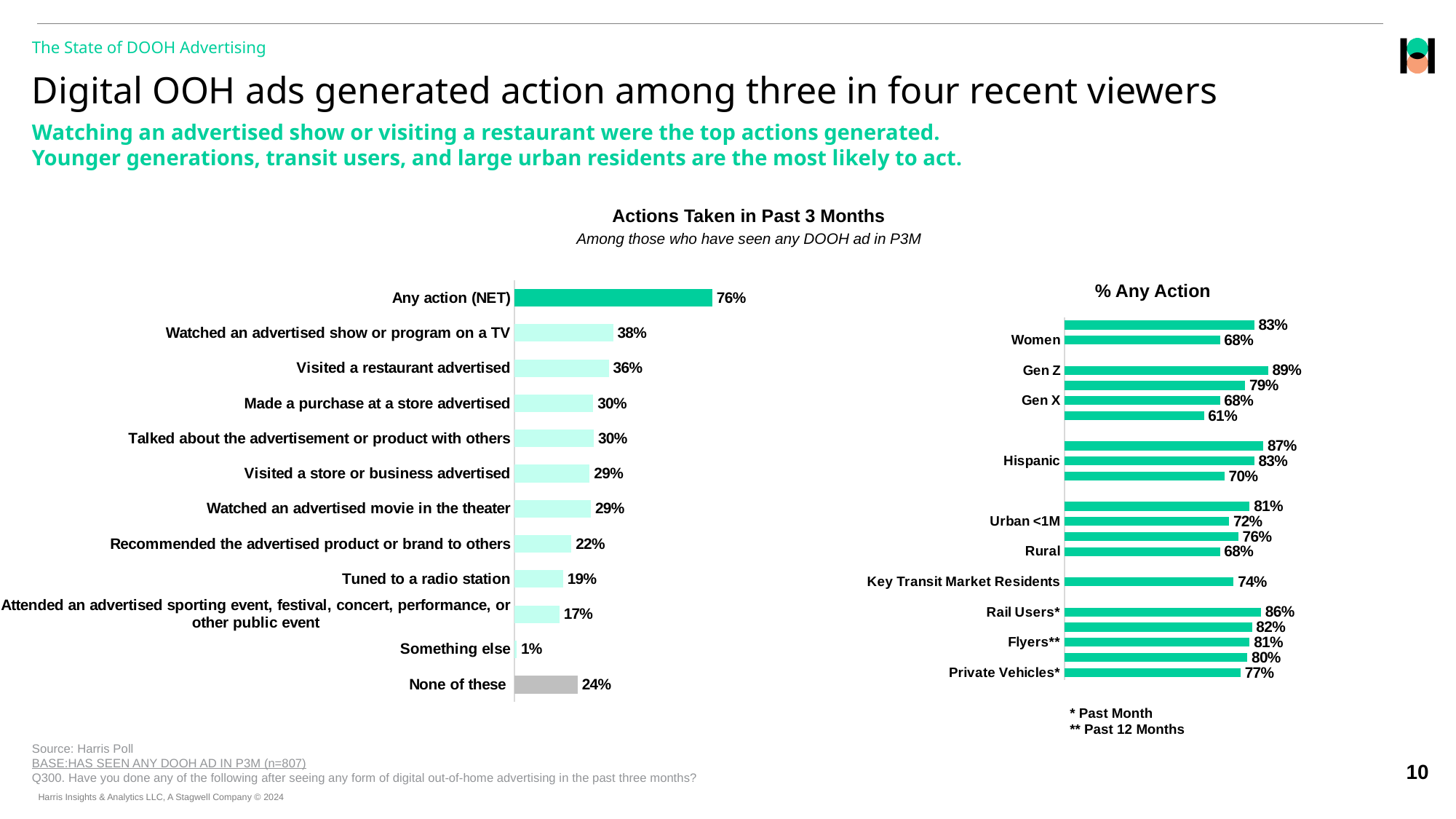
In the '% Any Action' chart, what is the value for 'Gen Z'? 89% In the '% Any Action' chart, what is the difference between 'Rail Users*' and 'Private Vehicles*'? 9% In the 'Actions Taken in Past 3 Months' chart, what is the value for 'Visited a restaurant advertised'? 36% In the 'Actions Taken in Past 3 Months' chart, which is larger: 'Recommended the advertised product or brand to others' or 'None of these'? None of these In the 'Actions Taken in Past 3 Months' chart, what is the difference between 'Watched an advertised show or program on a TV' and 'Visited a restaurant advertised'? 2% What type of chart is the 'Actions Taken in Past 3 Months' chart? Bar chart In the 'Actions Taken in Past 3 Months' chart, which category has the lowest value? Something else In the 'Actions Taken in Past 3 Months' chart, what is the value for 'Tuned to a radio station'? 19% How many categories are shown in the 'Actions Taken in Past 3 Months' chart? 12 In the '% Any Action' chart, what is the value for 'Key Transit Market Residents'? 74% In the 'Actions Taken in Past 3 Months' chart, which specific action (excluding the NET and 'None of these') has the highest value? Watched an advertised show or program on a TV In the 'Actions Taken in Past 3 Months' chart, what is the value for 'Any action (NET)'? 76%